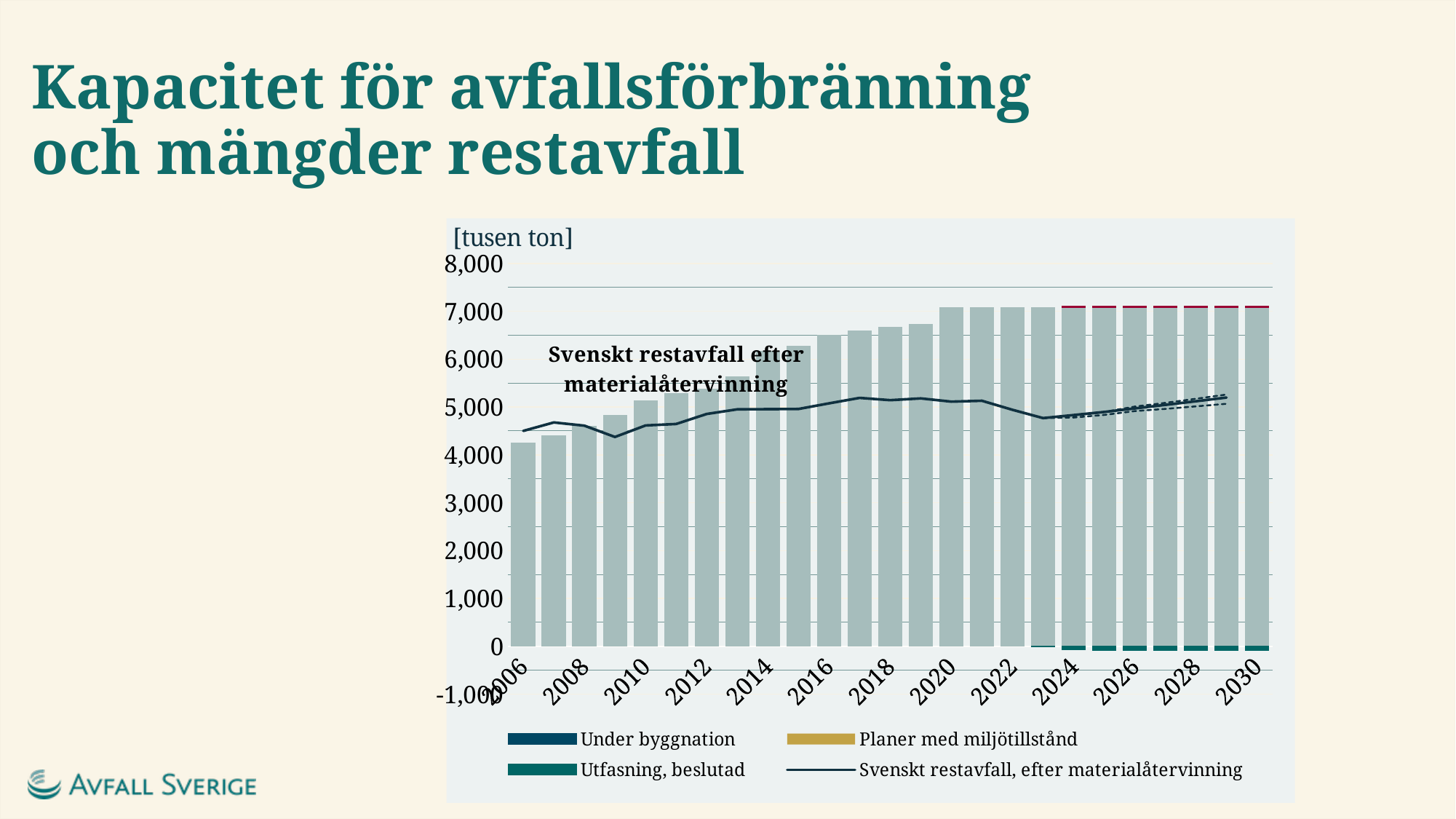
What unit is shown at the top of the y axis? [tusen ton] Do the bars rise or fall from 2006 to 2020? rise Which year has the lowest bar in the chart? 2006 Is the value of the 'Svenskt restavfall, efter materialåtervinning' line in 2006 greater or less than 5,000? less How many year labels are shown on the x axis? 13 Is the bar for 2006 greater or less than 5,000? less What kind of chart is shown on the slide? bar and line chart What is the first year labelled on the x axis? 2006 Which bar is taller, 2006 or 2016? 2016 How many entries does the chart legend list? 4 Is the value of the 'Svenskt restavfall, efter materialåtervinning' line in 2018 greater or less than 5,000? greater